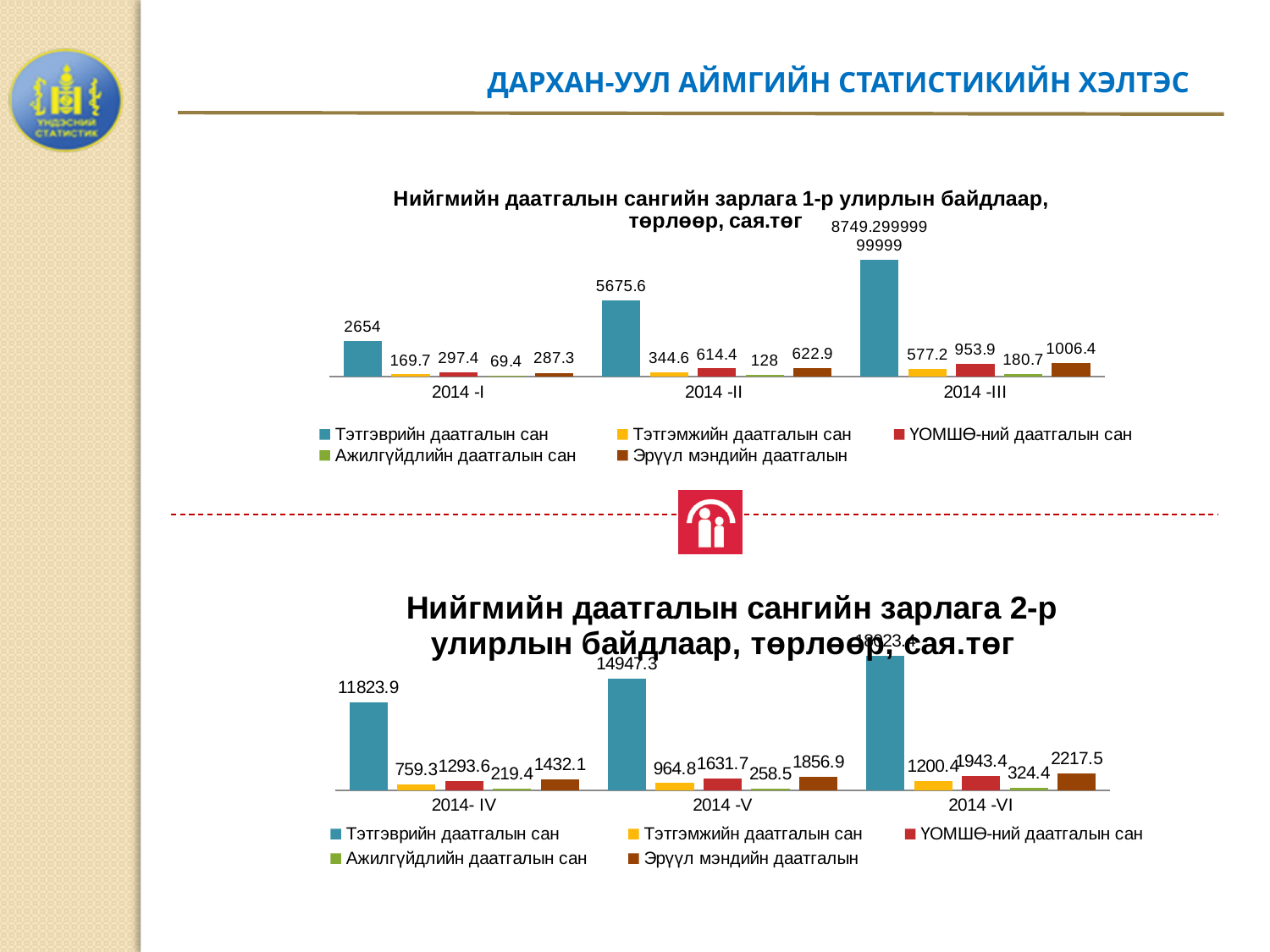
In the top chart (1-р улирлын байдлаар), how many series does the legend list? 5 In the top chart (1-р улирлын байдлаар), what is the difference between the Тэтгэврийн даатгалын сан values for 2014 -II and 2014 -I? 3021.6 In the top chart (1-р улирлын байдлаар), which category has the lowest value for Тэтгэмжийн даатгалын сан? 2014 -I In the bottom chart (2-р улирлын байдлаар), which category has the highest value for Эрүүл мэндийн даатгалын? 2014 -VI In the bottom chart (2-р улирлын байдлаар), what is the value of Тэтгэврийн даатгалын сан for 2014- IV? 11823.9 In the bottom chart (2-р улирлын байдлаар), which is larger for 2014 -VI: Тэтгэмжийн даатгалын сан or ҮОМШӨ-ний даатгалын сан? ҮОМШӨ-ний даатгалын сан In the top chart (1-р улирлын байдлаар), what is the value of Эрүүл мэндийн даатгалын for 2014 -II? 622.9 What type of chart is the bottom chart (2-р улирлын байдлаар)? Bar chart In the bottom chart (2-р улирлын байдлаар), what is the value of ҮОМШӨ-ний даатгалын сан for 2014 -V? 1631.7 In the bottom chart (2-р улирлын байдлаар), how does the value of Ажилгүйдлийн даатгалын сан change from 2014- IV to 2014 -VI? It rises In the top chart (1-р улирлын байдлаар), what is the value of Тэтгэврийн даатгалын сан for 2014 -I? 2654 In the top chart (1-р улирлын байдлаар), what is the value of Ажилгүйдлийн даатгалын сан for 2014 -III? 180.7